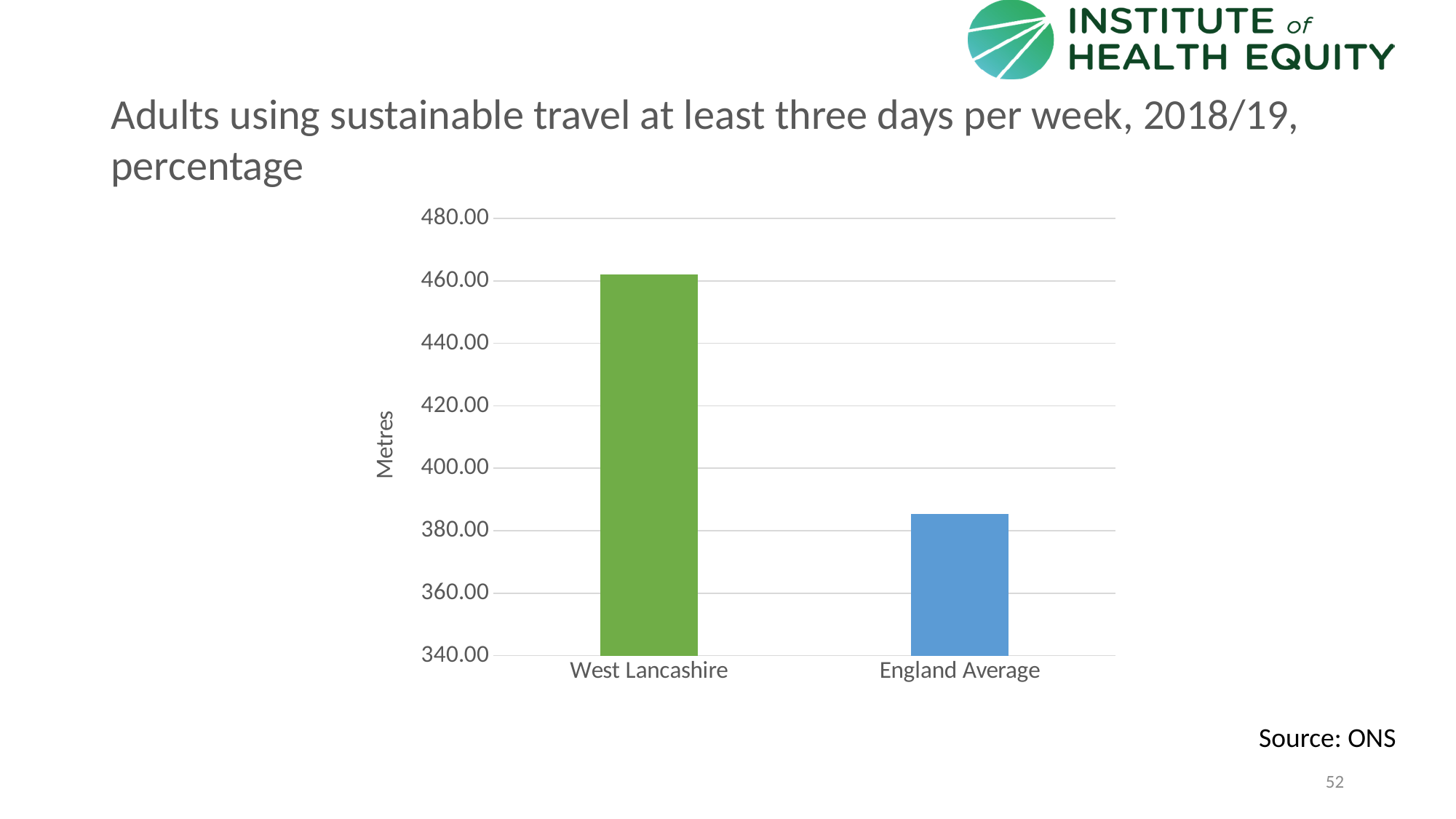
Which category has the lowest value in the chart? England Average Is the value for West Lancashire greater or less than 440.00? greater Which is larger, the value for West Lancashire or the value for England Average? West Lancashire What kind of chart is shown on the slide? Bar chart What source is cited for the chart on the slide? ONS What is the label on the vertical axis of the chart? Metres Is the value for England Average greater or less than 400.00? less Which category has the highest value in the chart? West Lancashire Is the value for England Average greater or less than 360.00? greater How many categories are plotted in the chart? 2